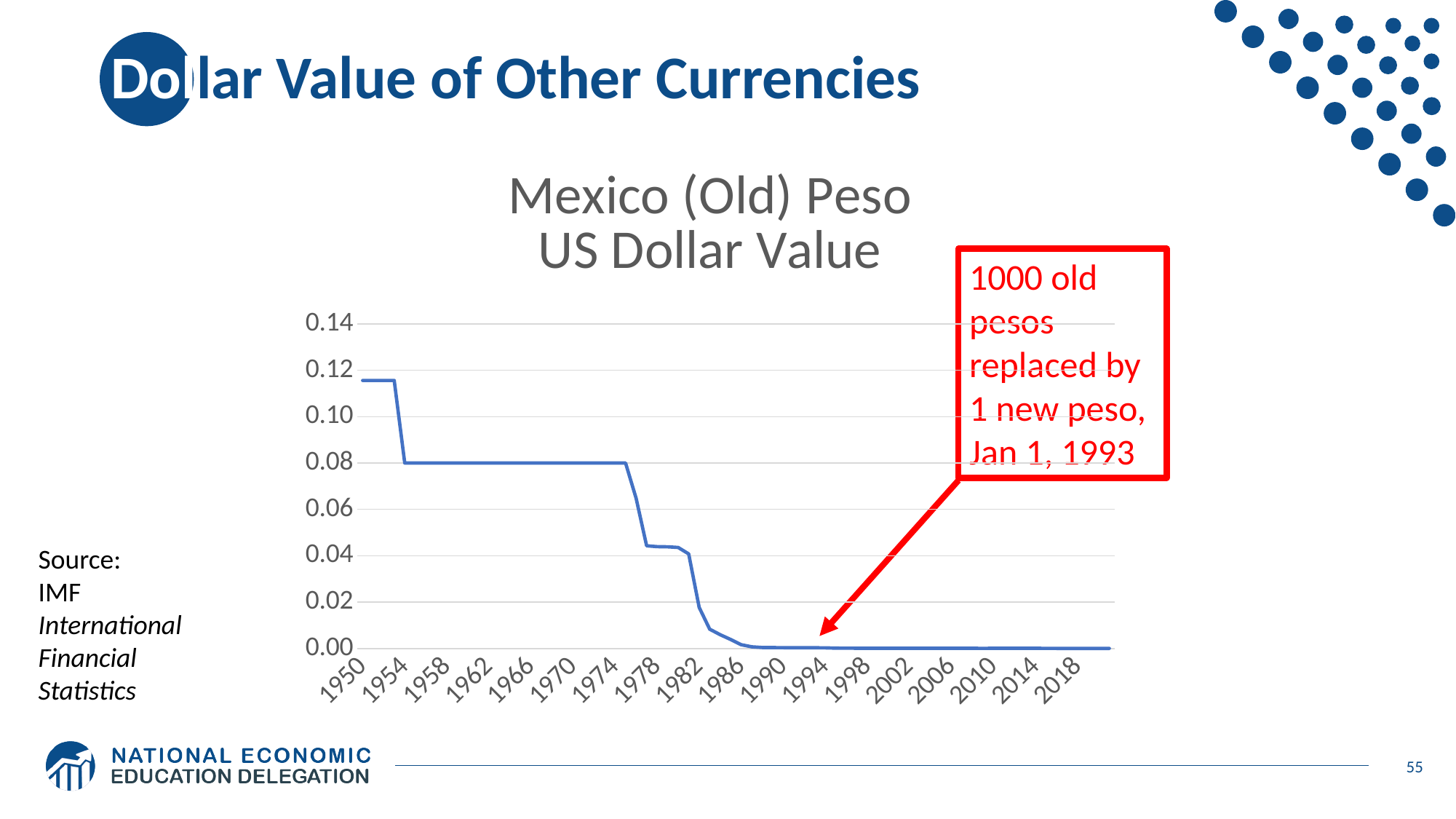
Is the value for 1978 greater or less than 0.06? less Is the value for 1958 greater or less than 0.10? less What kind of chart is shown on the slide? line chart Which year has the higher value, 1978 or 1990? 1978 Does the value of the Mexican old peso rise or fall over the period shown on the x axis? fall Is the value for 1950 greater or less than 0.10? greater How many year labels are shown on the x axis? 18 Which year has the higher value, 1950 or 1970? 1950 What is the title of the chart? Mexico (Old) Peso US Dollar Value What is the highest value shown on the y axis? 0.14